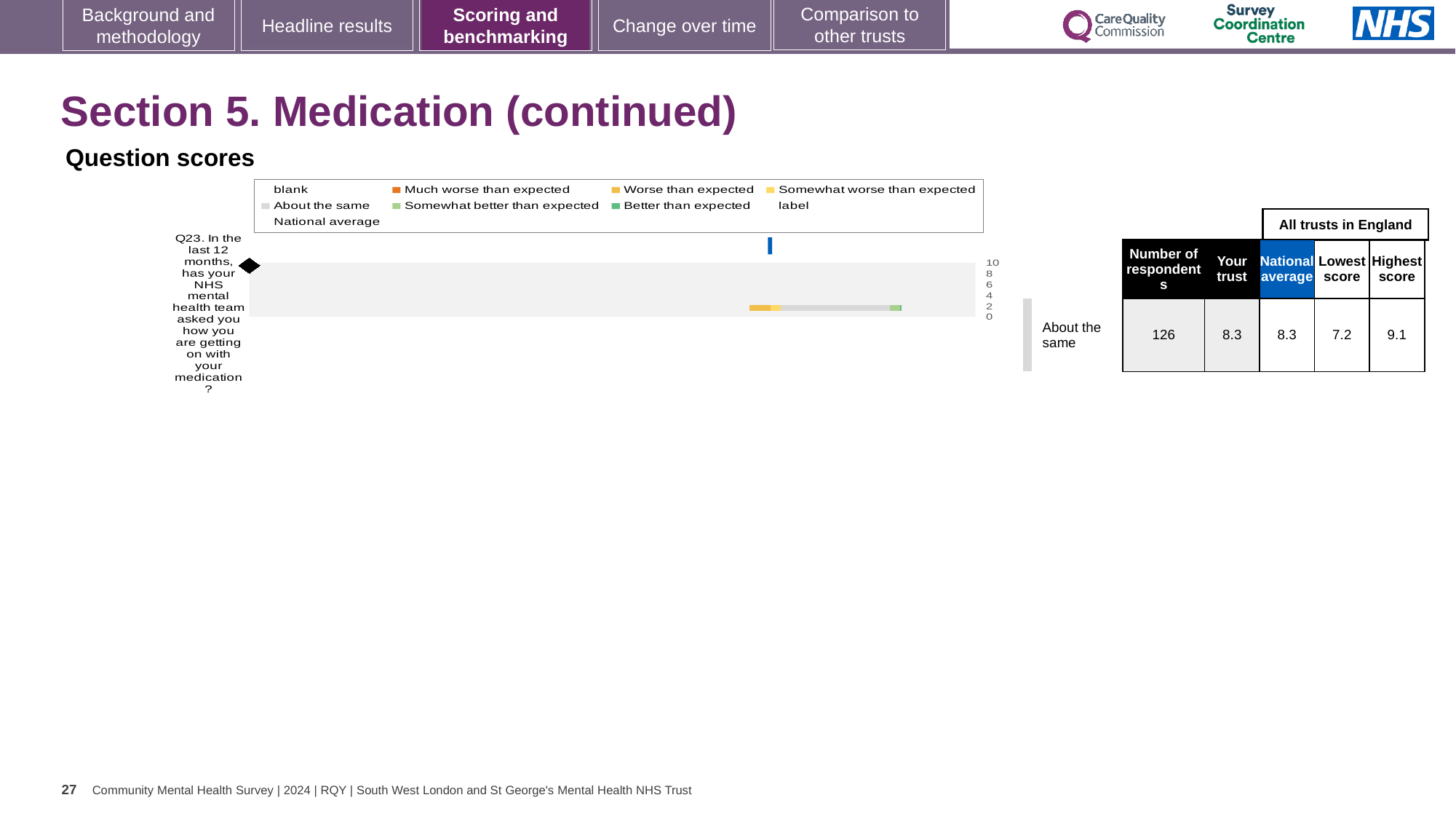
What kind of chart is shown under 'Question scores'? bar chart How many respondents answered Q23? 126 What is the national average score for Q23? 8.3 What benchmarking category is the trust's Q23 score placed in? About the same Is the 'Your trust' score for Q23 larger than, smaller than, or equal to the national average? equal How many questions are plotted on the chart? 1 What is the highest score among all trusts in England for Q23? 9.1 What is the lowest score among all trusts in England for Q23? 7.2 What is the 'Your trust' score for Q23? 8.3 Which question is plotted on the chart? Q23. In the last 12 months, has your NHS mental health team asked you how you are getting on with your medication? What is the difference between the highest score and the lowest score for Q23? 1.9 What is the highest value shown on the chart's axis? 10